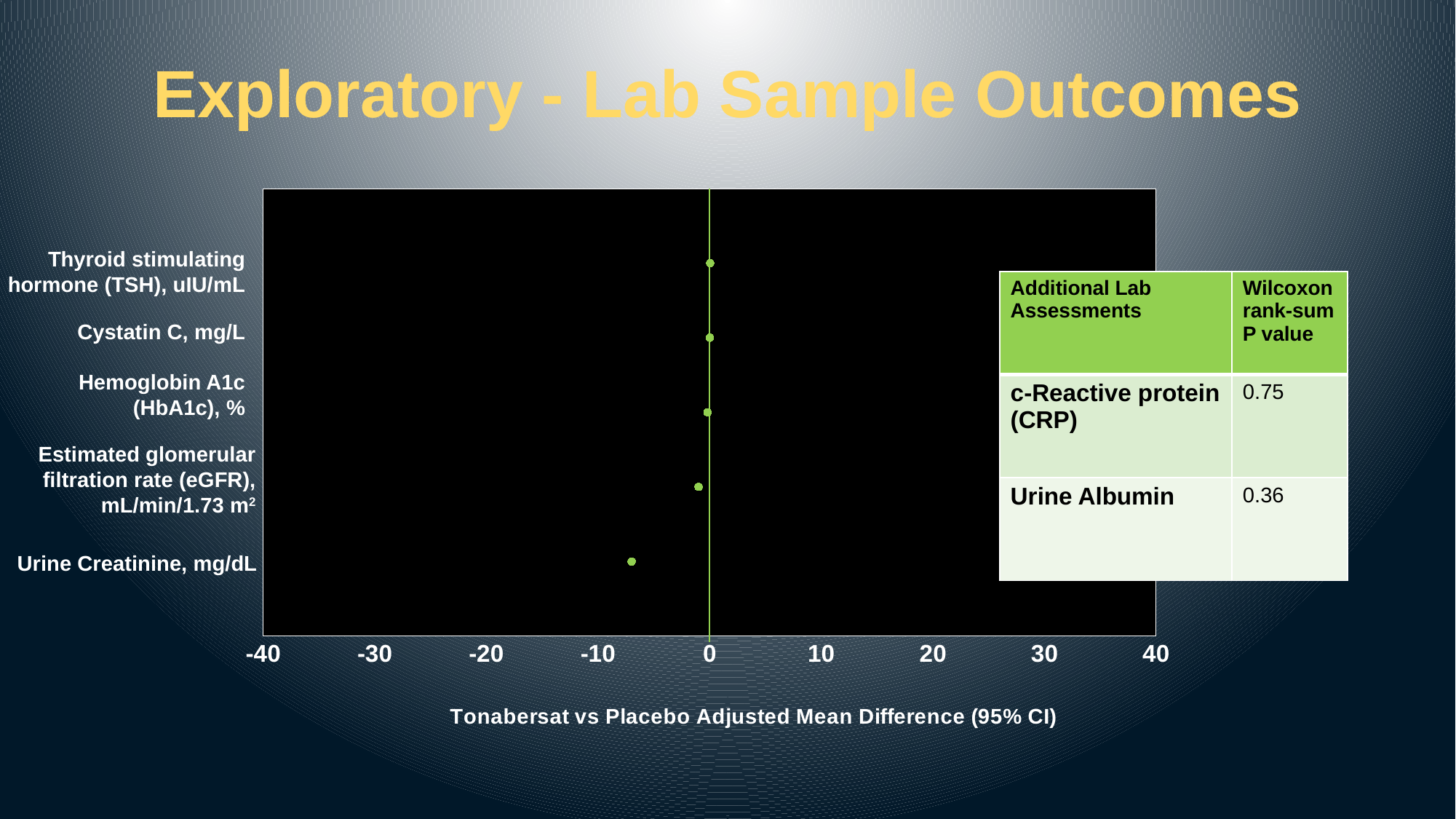
Which is larger, the value for Cystatin C, mg/L or the value for Urine Creatinine, mg/dL? Cystatin C, mg/L Which category has the lowest (most negative) adjusted mean difference? Urine Creatinine, mg/dL Which is larger, the value for Thyroid stimulating hormone (TSH), uIU/mL or the value for Urine Creatinine, mg/dL? Thyroid stimulating hormone (TSH), uIU/mL Is the value for Urine Creatinine, mg/dL greater or less than 0? less Is the value for Thyroid stimulating hormone (TSH), uIU/mL greater or less than 10? less Is the value for Estimated glomerular filtration rate (eGFR), mL/min/1.73 m² greater or less than -10? greater What is the lowest value shown on the x axis of the chart? -40 How many lab outcome categories are plotted on the chart? 5 What kind of chart is shown on the slide? Scatter (dot) plot What is the x-axis title of the chart? Tonabersat vs Placebo Adjusted Mean Difference (95% CI)